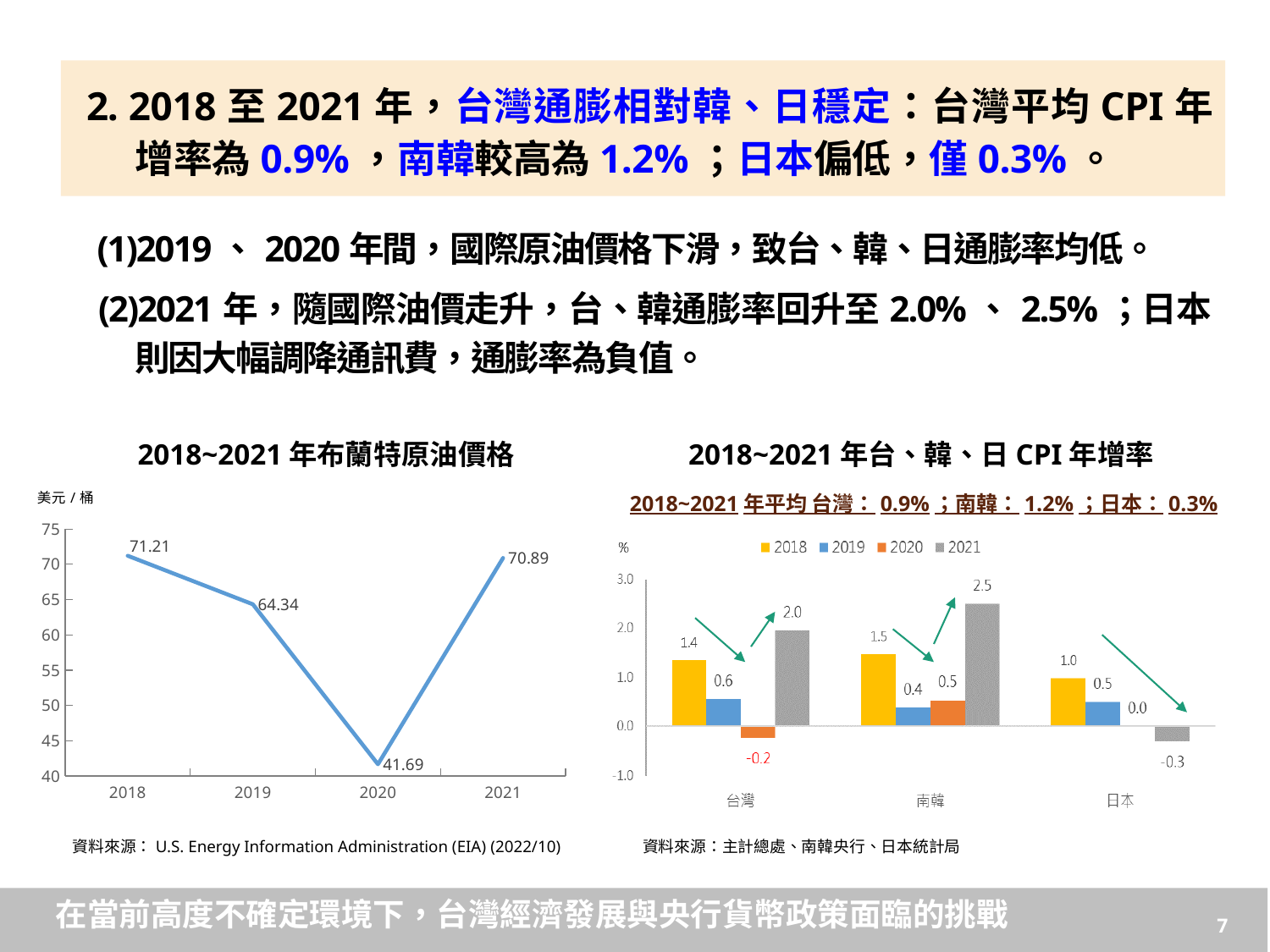
In the chart titled 2018~2021 年布蘭特原油價格, how many data points are plotted? 4 In the chart titled 2018~2021 年台、韓、日 CPI 年增率, what kind of chart is shown? bar chart In the chart titled 2018~2021 年台、韓、日 CPI 年增率, which is larger: the 2018 value for 台灣 or the 2018 value for 日本? 台灣 In the chart titled 2018~2021 年台、韓、日 CPI 年增率, how many series does the legend list? 4 In the chart titled 2018~2021 年台、韓、日 CPI 年增率, what is the 2021 value for 南韓? 2.5 In the chart titled 2018~2021 年台、韓、日 CPI 年增率, which country has the lowest 2021 value? 日本 In the chart titled 2018~2021 年布蘭特原油價格, which year has the highest value? 2018 In the chart titled 2018~2021 年布蘭特原油價格, what kind of chart is shown? line chart In the chart titled 2018~2021 年布蘭特原油價格, what is the value for 2020? 41.69 In the chart titled 2018~2021 年台、韓、日 CPI 年增率, what is the 2020 value for 台灣? -0.2 In the chart titled 2018~2021 年台、韓、日 CPI 年增率, what is the difference between the 2021 value for 南韓 and the 2021 value for 台灣? 0.5 In the chart titled 2018~2021 年布蘭特原油價格, what is the difference between the 2018 value and the 2019 value? 6.87